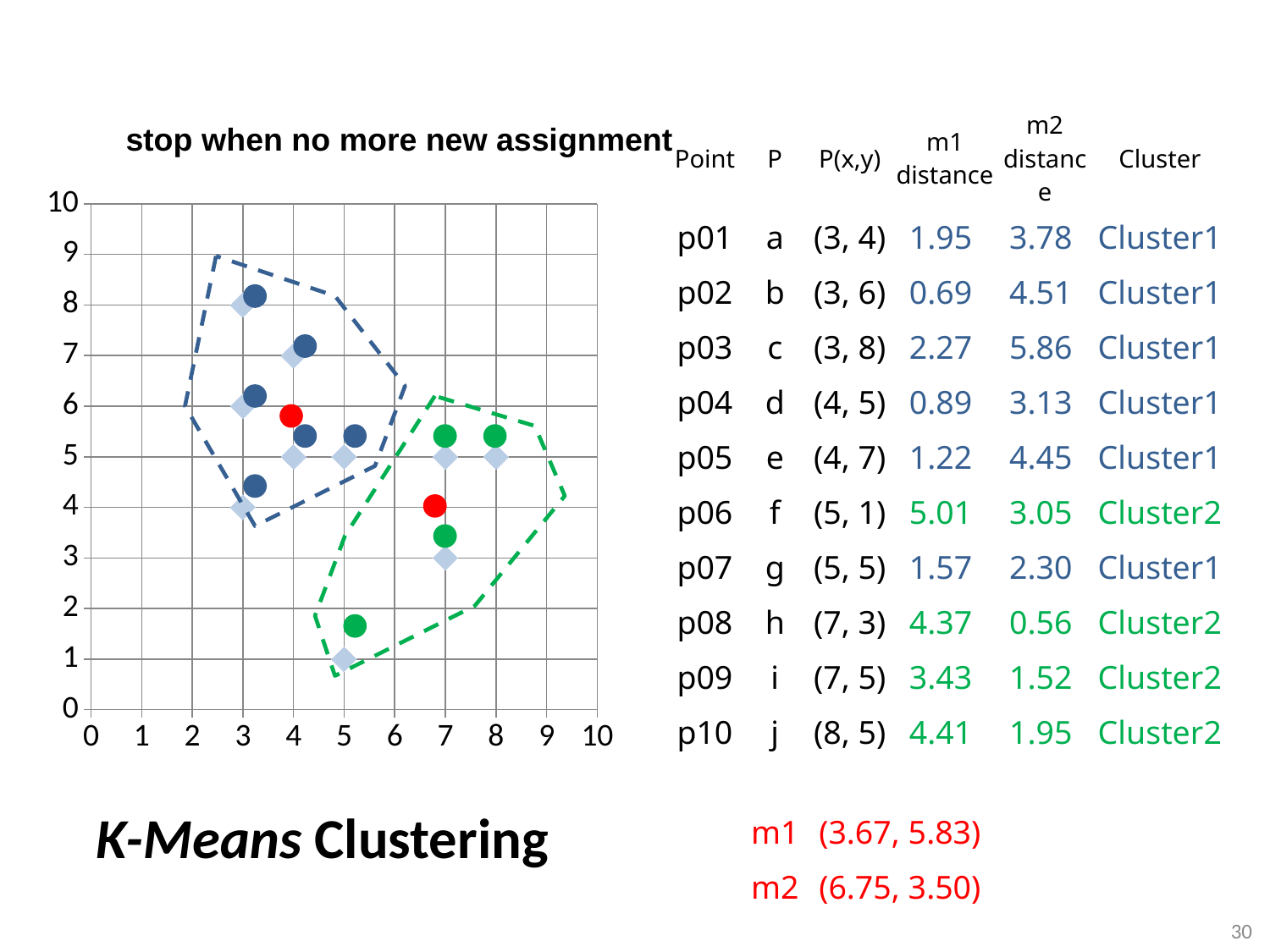
What kind of chart is shown on the left of the slide? scatter chart Is the y value of point f greater or less than 2? less What are the coordinates of centroid m2? (6.75, 3.50) What is the highest value shown on the chart's y axis? 10 What are the (x, y) coordinates of point h? (7, 3) Which point has the highest y value in the chart? c Which cluster contains more points, Cluster1 or Cluster2? Cluster1 What is the title shown above the chart? stop when no more new assignment Which cluster is point g (5, 5) assigned to? Cluster1 What is the m1 distance for point p04? 0.89 Which point has the lowest y value in the chart? f How many data points (a through j) are plotted in the chart? 10